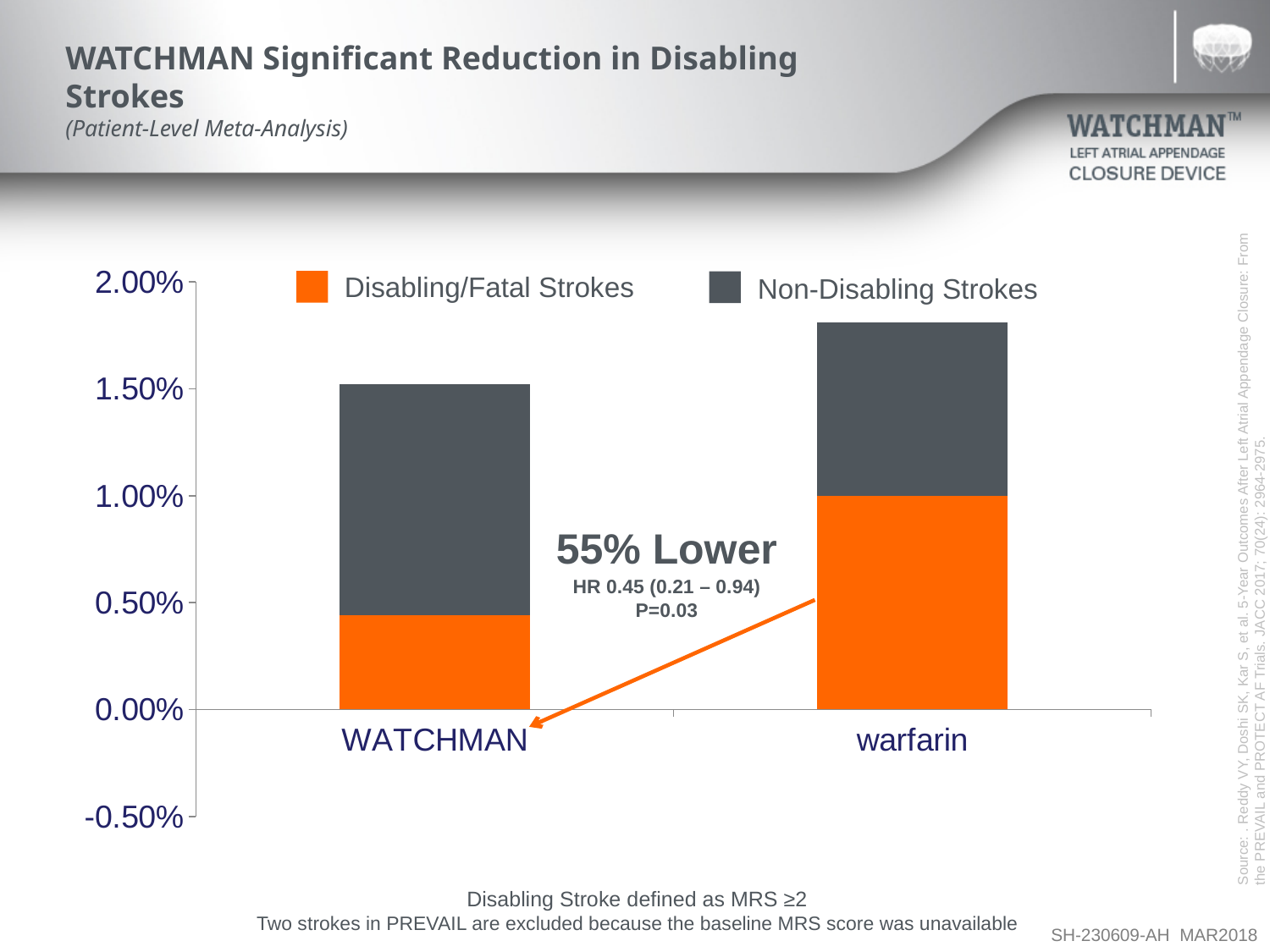
Which colour represents Disabling/Fatal Strokes in the chart's legend? orange Is the Disabling/Fatal Strokes value for warfarin greater or less than 0.50%? greater Which category has the taller total stacked bar, WATCHMAN or warfarin? warfarin Which category has the larger Disabling/Fatal Strokes segment, WATCHMAN or warfarin? warfarin What percentage reduction is annotated between the two bars on the chart? 55% Lower Is the total stacked value for WATCHMAN greater or less than 1.00%? greater What kind of chart is shown on the slide? stacked bar chart How many series does the chart's legend list? 2 Which category has the larger Non-Disabling Strokes segment, WATCHMAN or warfarin? WATCHMAN How many categories are shown on the x axis of the chart? 2 Is the total stacked value for warfarin greater or less than 2.00%? less